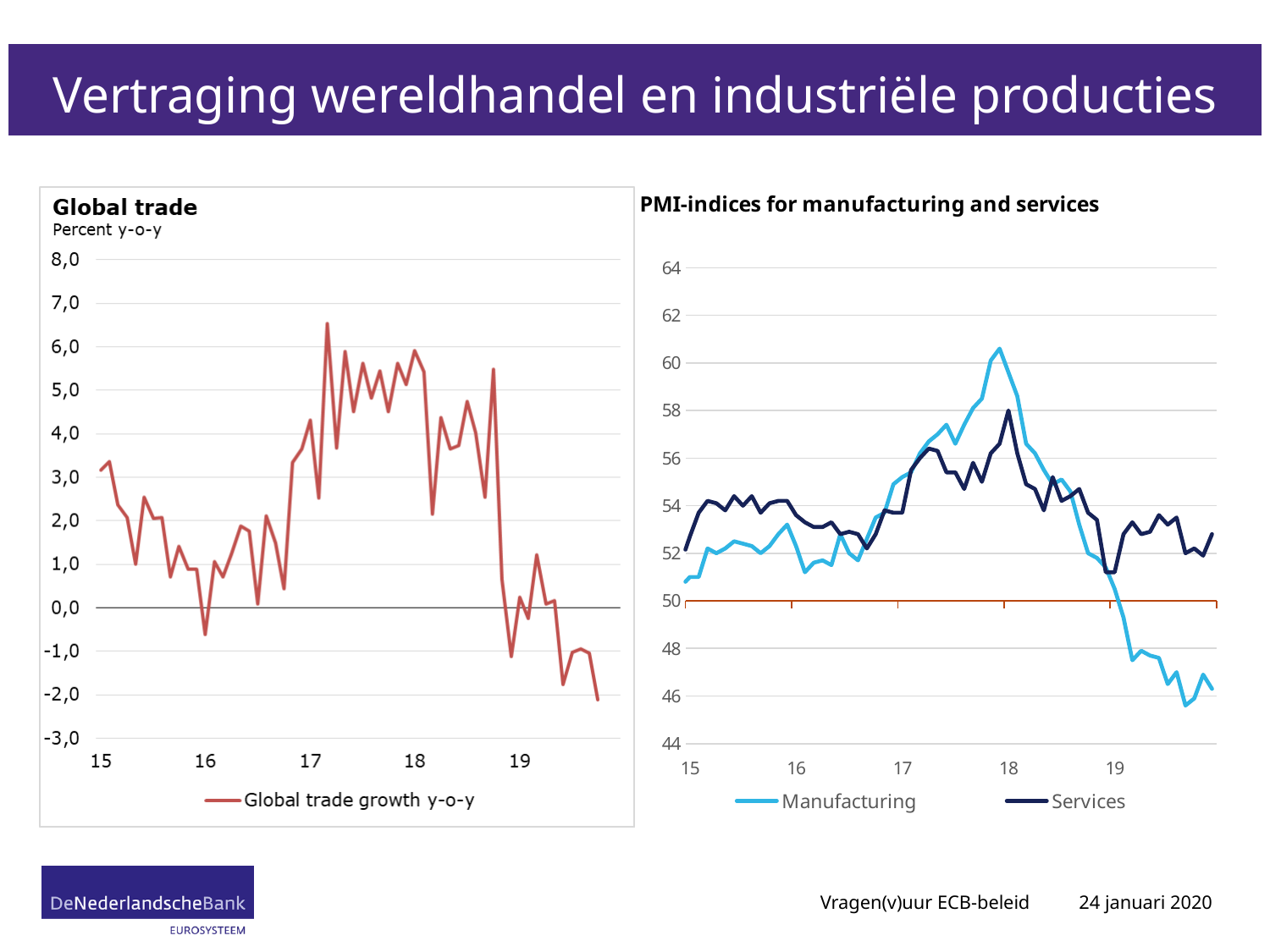
What kind of chart is the 'PMI-indices for manufacturing and services' chart on the right? line chart How many series does the legend of the 'PMI-indices for manufacturing and services' chart list? 2 In the 'Global trade' chart, is the last value of Global trade growth y-o-y (late 2019) greater or less than 0,0? less In the 'PMI-indices for manufacturing and services' chart, is the Manufacturing value at the end of the series (late 2019) greater or less than 50? less What kind of chart is the 'Global trade' chart on the left? line chart In the 'PMI-indices for manufacturing and services' chart, which series is shown in light blue? Manufacturing In the 'PMI-indices for manufacturing and services' chart, does the Manufacturing series rise or fall from the start of 2018 to the end of 2019? fall In the 'PMI-indices for manufacturing and services' chart, is the Services value at the end of the series (late 2019) greater or less than 50? greater How many series does the legend of the 'Global trade' chart list? 1 What is the unit shown under the title of the 'Global trade' chart? Percent y-o-y In the 'PMI-indices for manufacturing and services' chart, which series is higher at the end of the series in late 2019, Manufacturing or Services? Services